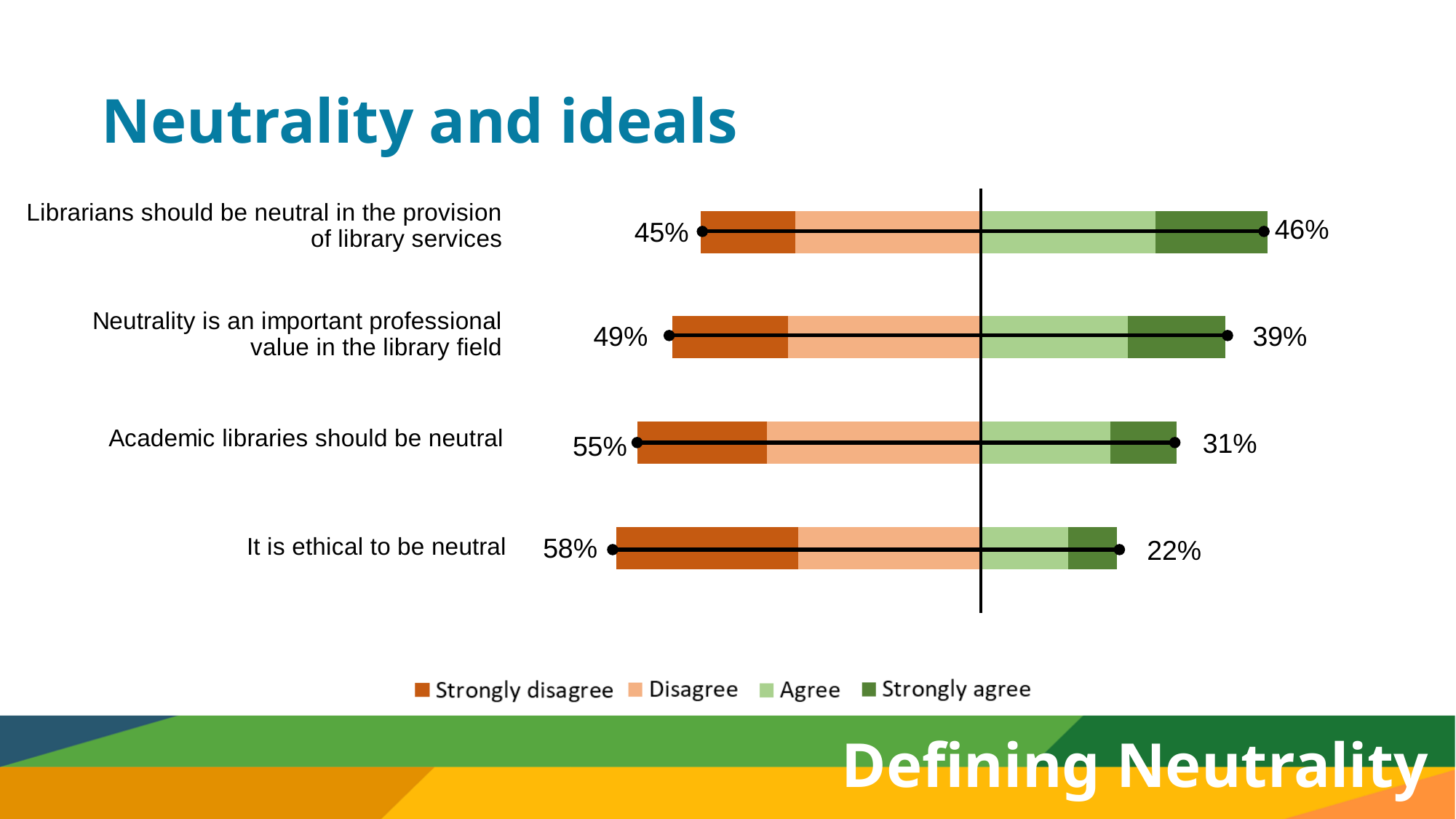
Which statement has the lowest combined agree percentage? It is ethical to be neutral What percentage agreed (combined) with the statement "Librarians should be neutral in the provision of library services"? 46% What is the combined disagree percentage for "Neutrality is an important professional value in the library field"? 49% How many response categories does the legend list? 4 Which statement has the highest combined agree percentage? Librarians should be neutral in the provision of library services What type of chart is shown on the slide? Stacked bar chart What percentage disagreed (combined) with the statement "It is ethical to be neutral"? 58% For "Neutrality is an important professional value in the library field", is the disagree percentage or the agree percentage larger? Disagree (49%) Which statement has the highest combined disagree percentage? It is ethical to be neutral What is the combined agree percentage for "Academic libraries should be neutral"? 31% What is the difference between the disagree and agree percentages for "It is ethical to be neutral"? 36 percentage points How many statements are shown in the chart? 4